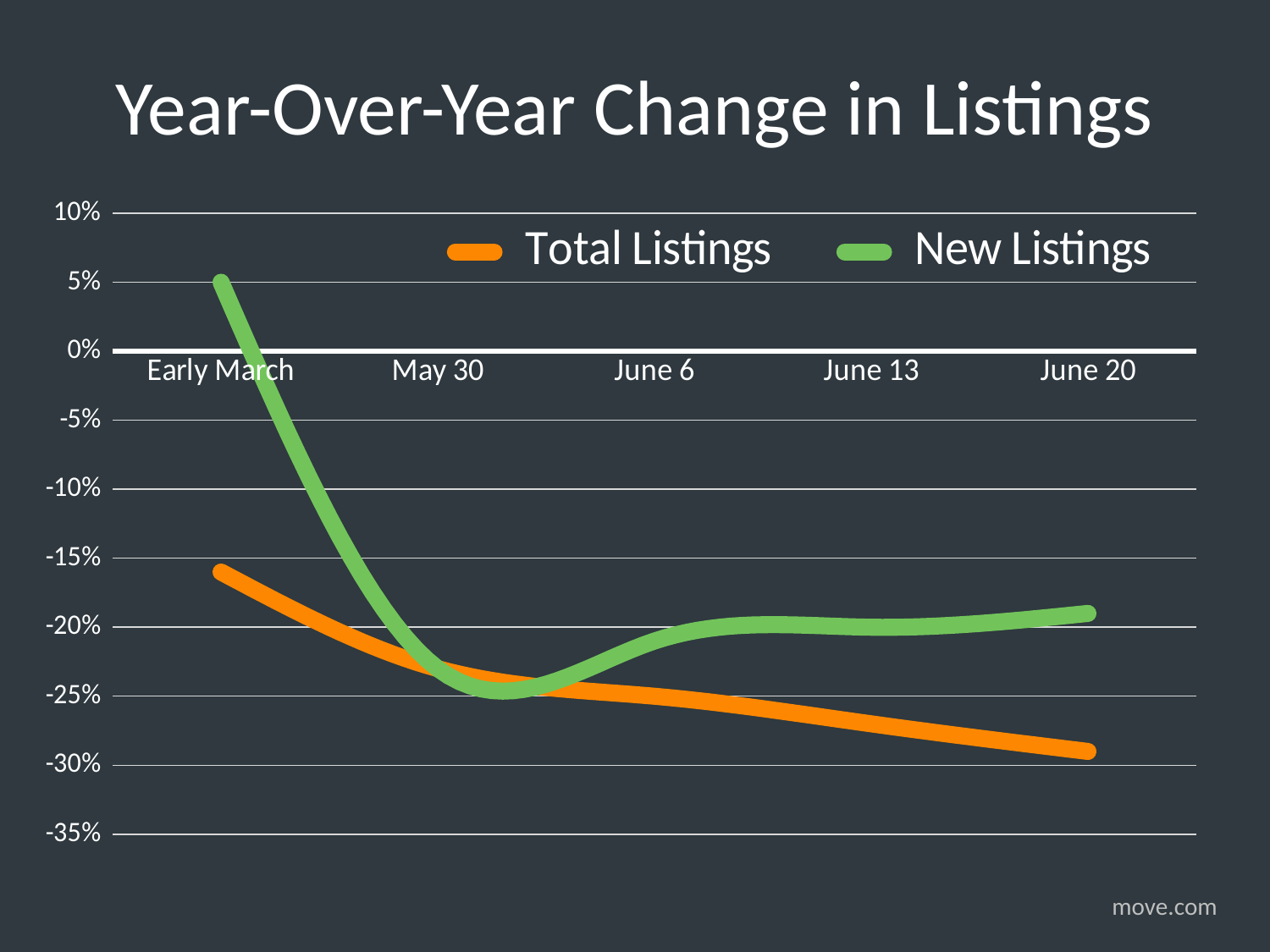
What is the title of the chart? Year-Over-Year Change in Listings Is the value for New Listings in Early March greater or less than 0%? greater How many series does the legend list? 2 At which point on the x axis is Total Listings at its lowest? June 20 At which point on the x axis is New Listings at its highest? Early March Is the value for New Listings on June 20 greater or less than -25%? greater On June 20, which series has the higher value, Total Listings or New Listings? New Listings How many points are plotted along the x axis for each series? 5 What colour is the Total Listings line? Orange What kind of chart is shown on the slide? Line chart Is the value for Total Listings in Early March greater or less than -10%? less